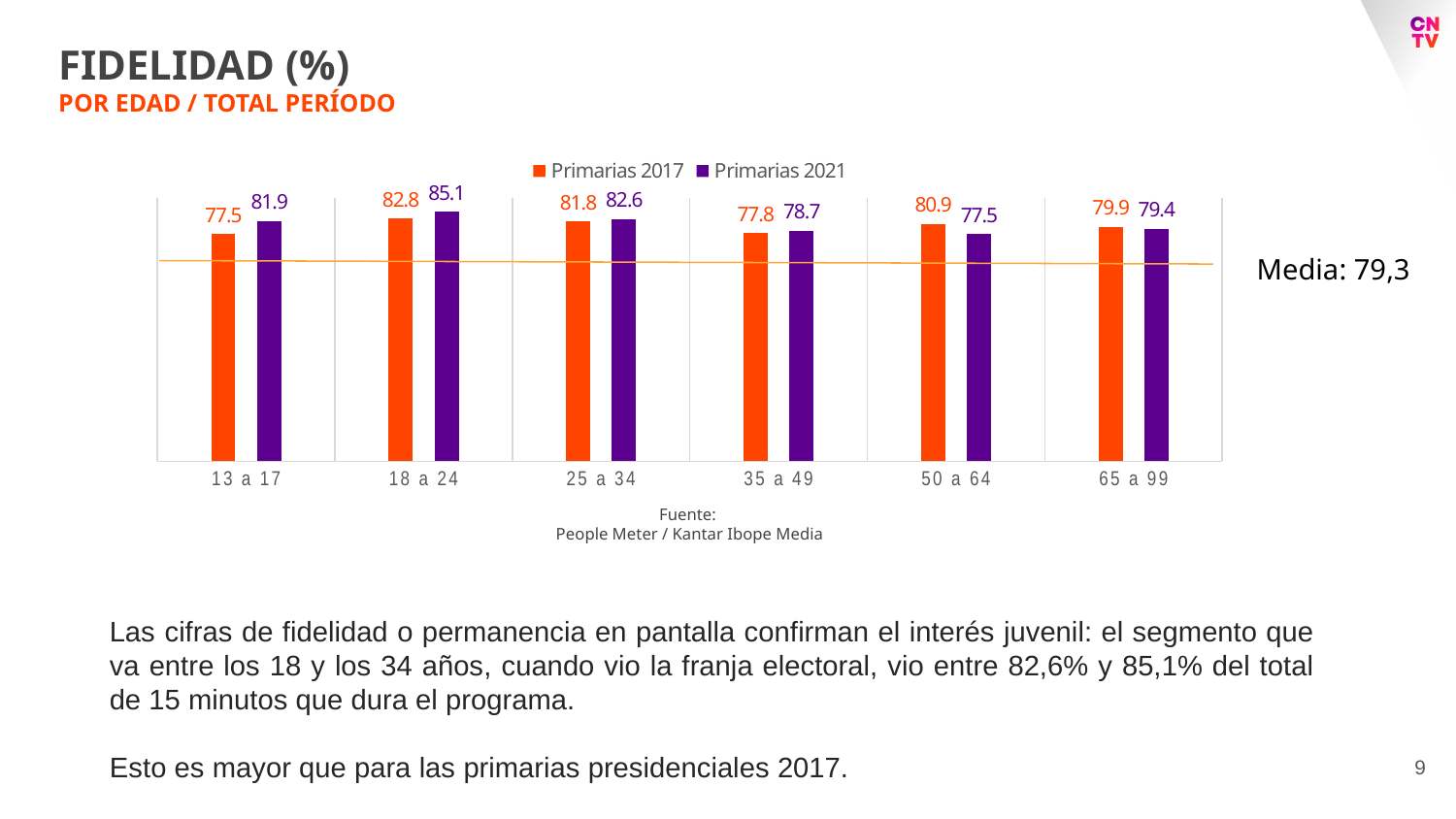
Which age group has the lowest Primarias 2017 value? 13 a 17 What type of chart is shown on the slide? Bar chart What is the Primarias 2017 value for the 50 a 64 age group? 80.9 What is the Primarias 2021 value for the 13 a 17 age group? 81.9 What is the Primarias 2021 value for the 18 a 24 age group? 85.1 What is the value of the 'Media' (average) indicated next to the horizontal line on the chart? 79,3 How many series does the chart legend list? 2 What is the difference between the Primarias 2021 and Primarias 2017 values for the 13 a 17 age group? 4.4 For the 50 a 64 age group, which series has the larger value, Primarias 2017 or Primarias 2021? Primarias 2017 Which age group has the highest Primarias 2021 value? 18 a 24 How many age groups are shown on the x axis of the chart? 6 What is the Primarias 2017 value for the 65 a 99 age group? 79.9